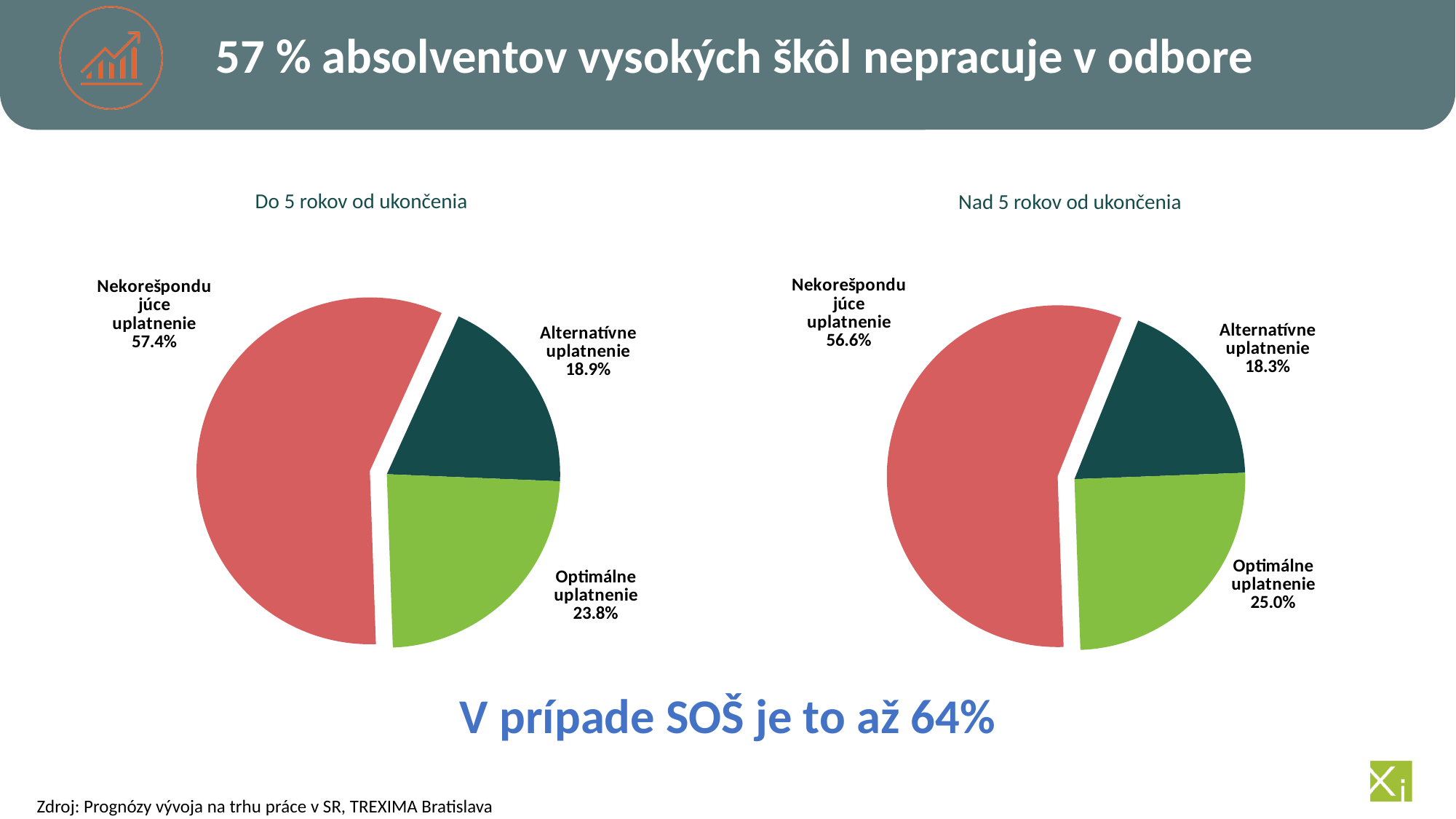
In the 'Nad 5 rokov od ukončenia' chart, what is the value for Alternatívne uplatnenie? 18.3% What type of chart is used on the left side of the slide? Pie chart In the 'Nad 5 rokov od ukončenia' chart, which category has the smallest share? Alternatívne uplatnenie Which chart has the larger value for Optimálne uplatnenie, 'Do 5 rokov od ukončenia' or 'Nad 5 rokov od ukončenia'? Nad 5 rokov od ukončenia In the 'Do 5 rokov od ukončenia' chart, what is the difference between Optimálne uplatnenie and Alternatívne uplatnenie? 4.9% In the 'Do 5 rokov od ukončenia' chart, what is the value for Alternatívne uplatnenie? 18.9% In the 'Do 5 rokov od ukončenia' chart, what colour is the Optimálne uplatnenie slice? Green In the 'Nad 5 rokov od ukončenia' chart, what is the value for Optimálne uplatnenie? 25.0% What is the title of the chart on the right side of the slide? Nad 5 rokov od ukončenia How many slices does the 'Nad 5 rokov od ukončenia' chart have? 3 In the 'Do 5 rokov od ukončenia' chart, which category has the largest share? Nekorešpondujúce uplatnenie In the 'Do 5 rokov od ukončenia' chart, what is the value for Nekorešpondujúce uplatnenie? 57.4%